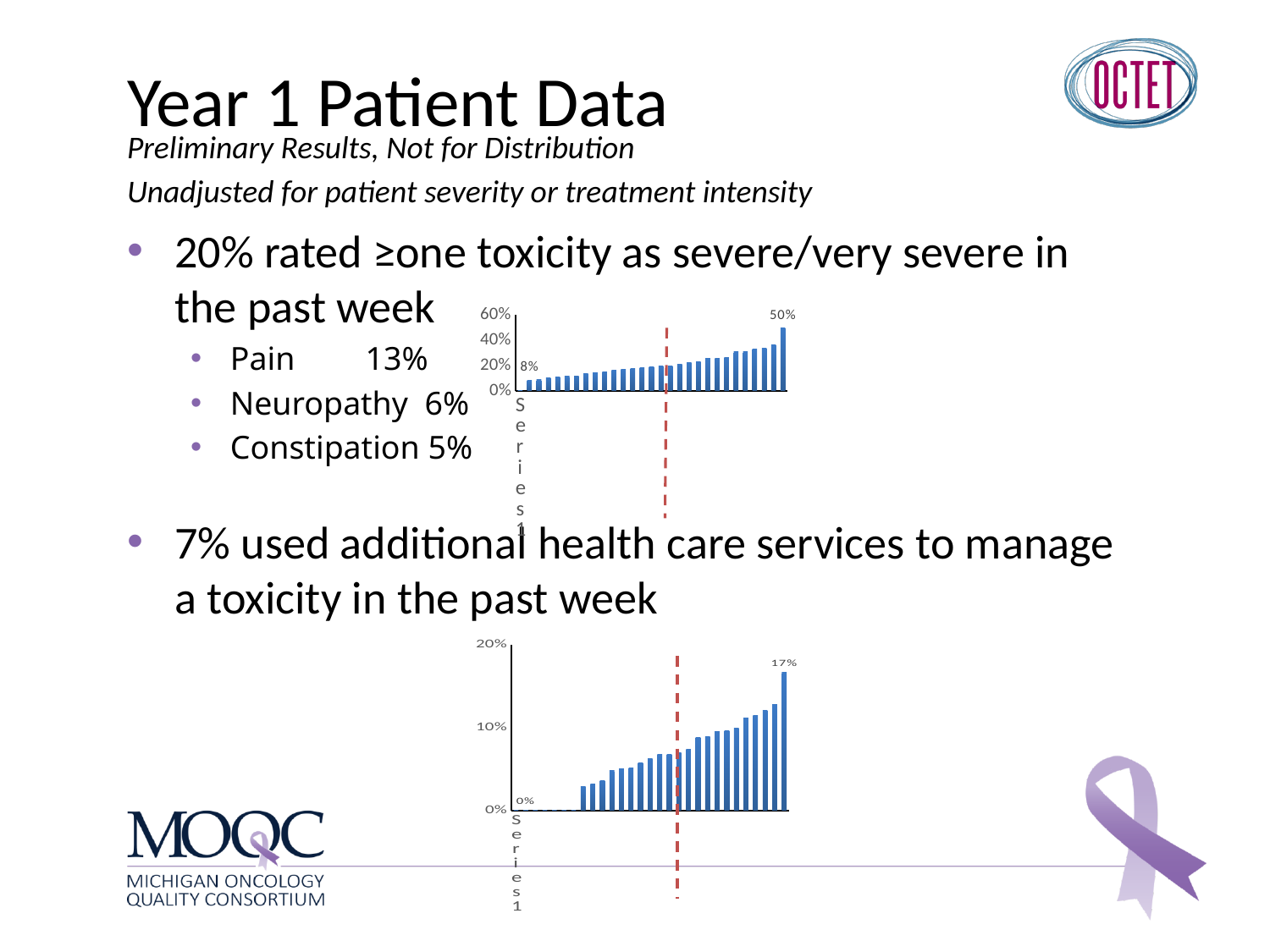
In the upper chart, is the second-tallest bar greater or less than 40%? less In the upper chart, what is the difference between the labelled highest value and the labelled lowest value? 42% In the upper chart, what is the value printed on the shortest (leftmost) bar? 8% Which chart has the larger labelled maximum value, the upper chart or the lower chart? the upper chart In the lower chart, do the bar values rise or fall from left to right? rise What is the highest value shown on the y-axis of the upper chart? 60% In the lower chart, what is the difference between the labelled highest value and the labelled lowest value? 17% In the lower chart, what is the value printed on the tallest bar? 17% In the lower chart, is the second-tallest bar greater or less than 10%? greater In the lower chart, what is the value printed on the leftmost bar? 0% What kind of chart is the upper chart? bar chart In the upper chart, what is the value printed on the tallest bar? 50%